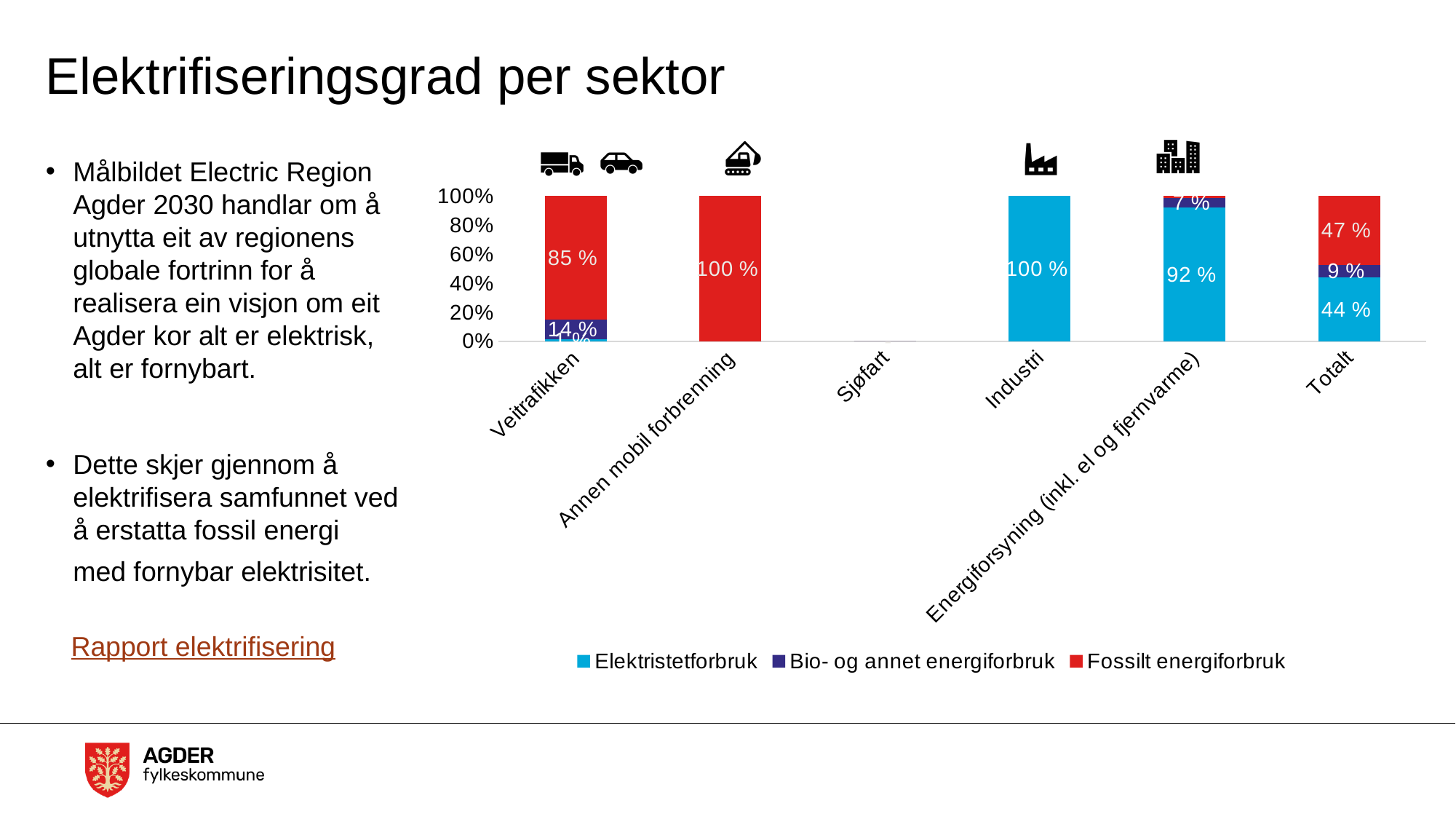
Which is larger for Totalt, the Fossilt energiforbruk share or the Elektristetforbruk share? Fossilt energiforbruk What is the Fossilt energiforbruk share for Annen mobil forbrenning? 100 % How many series does the legend list? 3 What is the Bio- og annet energiforbruk share for Totalt? 9 % What is the Fossilt energiforbruk share for Totalt? 47 % What is the Elektristetforbruk share for Energiforsyning (inkl. el og fjernvarme)? 92 % What is the Elektristetforbruk share for Industri? 100 % What is the difference between the Fossilt energiforbruk share and the Elektristetforbruk share for Totalt? 3 % How many categories are shown on the x axis? 6 What kind of chart is shown on the slide? Stacked bar chart What is the Fossilt energiforbruk share for Veitrafikken? 85 % Which colour represents Fossilt energiforbruk in the chart? Red